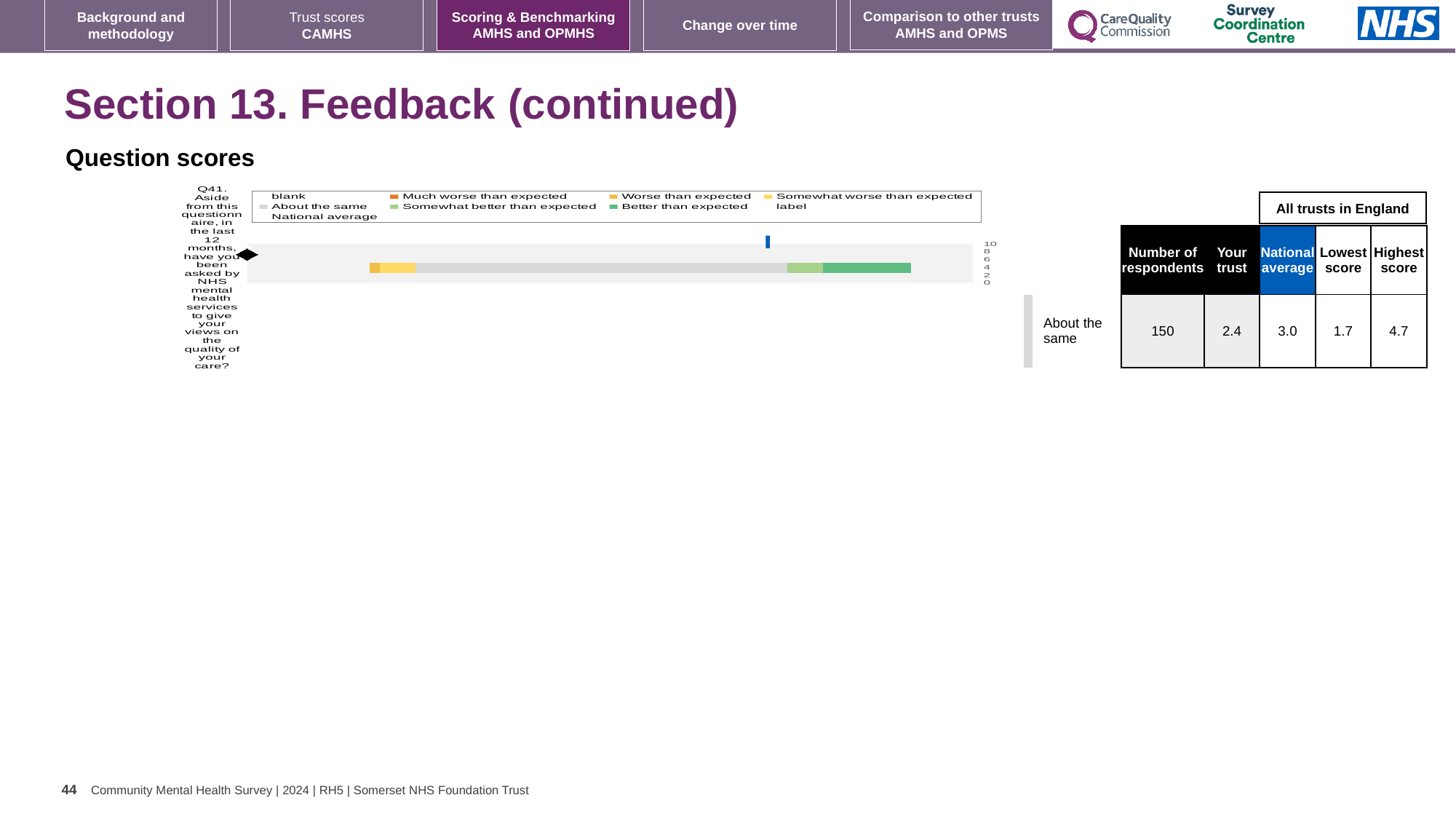
What is the highest score among all trusts in England for Q41? 4.7 What is the difference between the national average and the 'Your trust' score for Q41? 0.6 What is the lowest score among all trusts in England for Q41? 1.7 Which is larger for Q41, the 'Your trust' score or the national average? National average Which question is plotted in the chart? Q41 What is the national average score for Q41? 3.0 How many questions (categories) are plotted in the chart? 1 Which legend entry is shown in dark green? Better than expected What is the difference between the highest score and the lowest score for Q41? 3.0 What is the 'Your trust' score for Q41? 2.4 How many respondents answered Q41? 150 What kind of chart is shown on the slide? bar chart